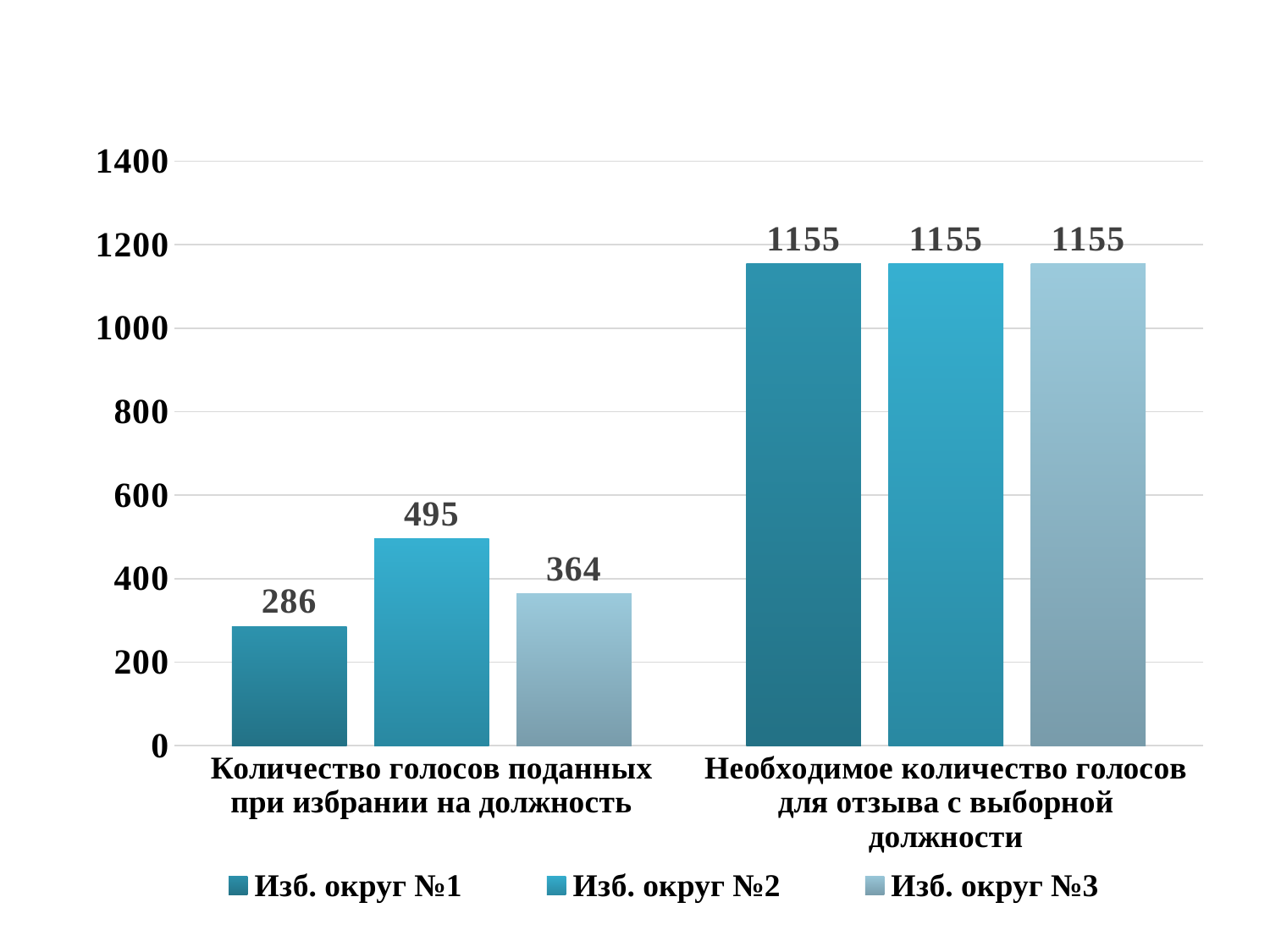
How many series does the legend list? 3 Which is larger: the value for Изб. округ №3 or Изб. округ №1 in the category "Количество голосов поданных при избрании на должность"? Изб. округ №3 What is the difference between the required votes for recall (1155) and the votes cast at election for Изб. округ №3 (364)? 791 Which series has the highest value in the category "Количество голосов поданных при избрании на должность"? Изб. округ №2 How many categories are shown on the x axis? 2 What is the value for Изб. округ №3 in the category "Количество голосов поданных при избрании на должность"? 364 What is the value for Изб. округ №1 in the category "Количество голосов поданных при избрании на должность"? 286 What is the value for Изб. округ №2 in the category "Количество голосов поданных при избрании на должность"? 495 What is the difference between the values for Изб. округ №2 and Изб. округ №1 in the category "Количество голосов поданных при избрании на должность"? 209 Which series has the lowest value in the category "Количество голосов поданных при избрании на должность"? Изб. округ №1 What is the value for Изб. округ №2 in the category "Необходимое количество голосов для отзыва с выборной должности"? 1155 What kind of chart is shown on the slide? Bar chart